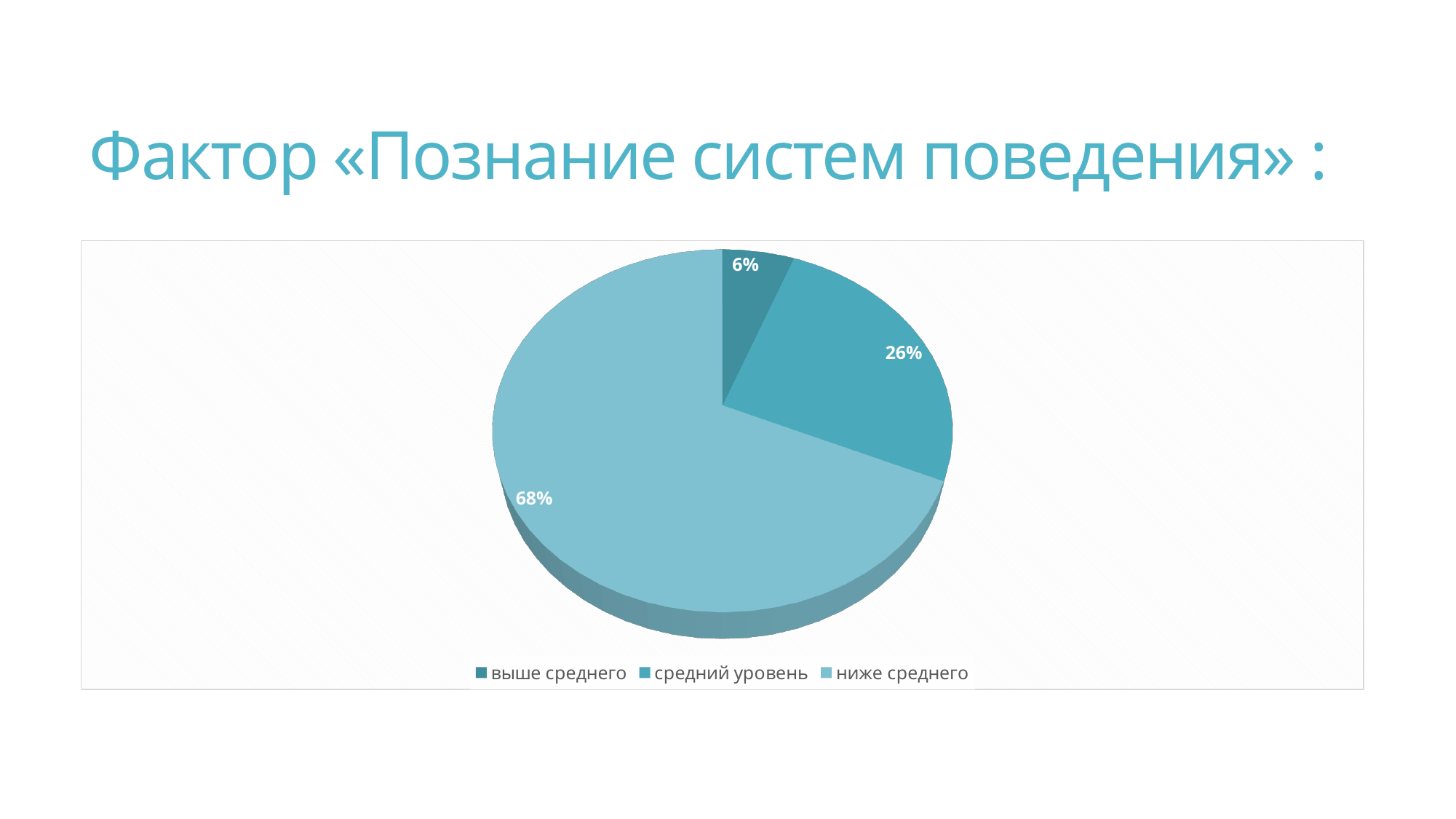
Which is larger, the share of "средний уровень" or the share of "выше среднего"? средний уровень What is the difference between the shares of "средний уровень" and "выше среднего"? 20% What kind of chart is shown on the slide? pie chart What share of the pie does "ниже среднего" take? 68% Which category has the smallest slice of the pie? выше среднего What share of the pie does "средний уровень" take? 26% What is the title of the slide containing the chart? Фактор «Познание систем поведения» : How many categories does the pie chart show? 3 What share of the pie does "выше среднего" take? 6% What is the difference between the shares of "ниже среднего" and "средний уровень"? 42% Which category has the largest slice of the pie? ниже среднего Which legend entry is listed first? выше среднего